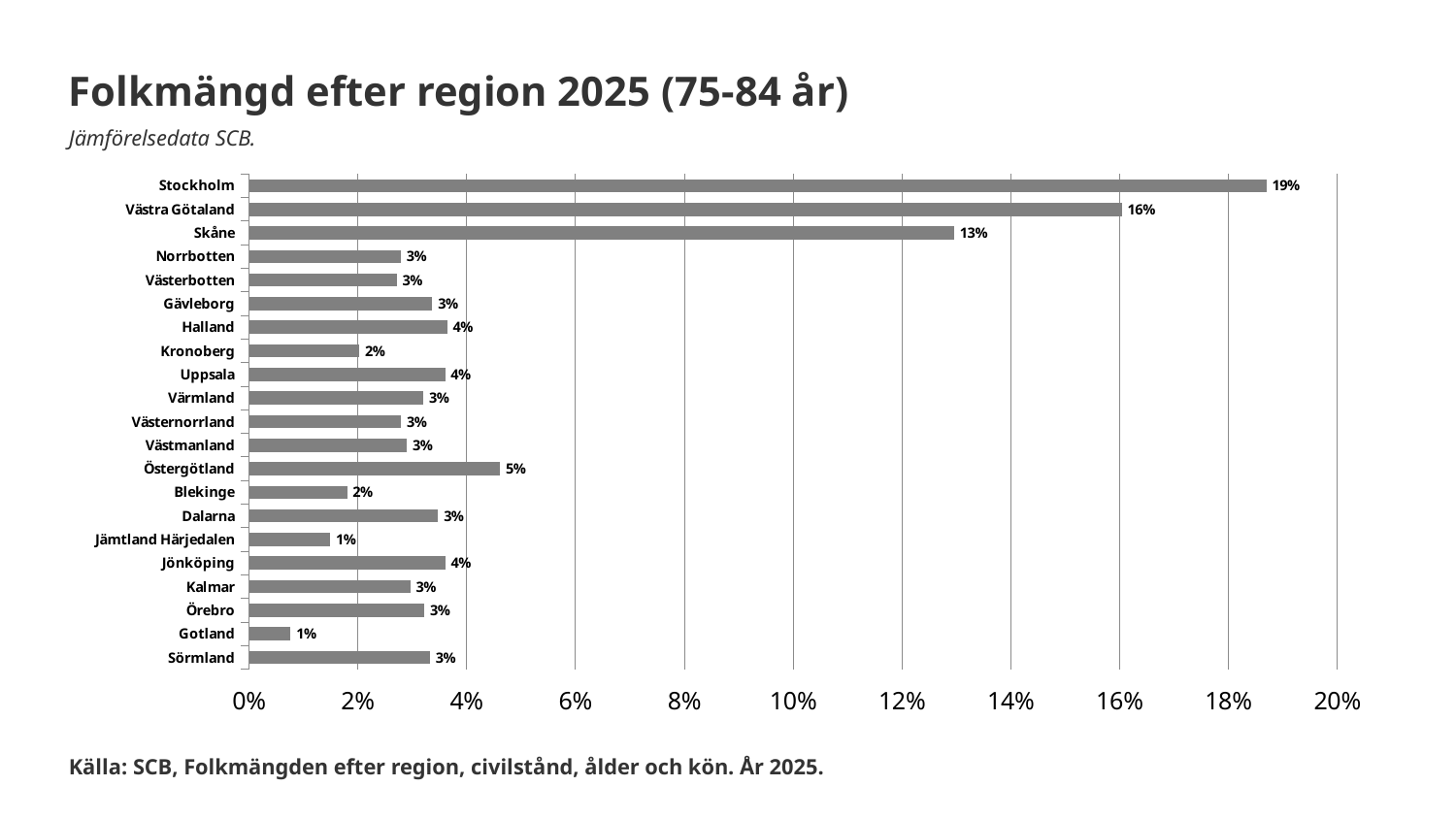
Is the value for Skåne greater or less than 12%? greater What is the difference between the values for Västra Götaland and Skåne? 3% What kind of chart is shown on the slide? Bar chart What is the value for Östergötland? 5% Which is larger, the value for Östergötland or the value for Blekinge? Östergötland What is the value for Kronoberg? 2% What is the value for Västra Götaland? 16% Which region has the highest value? Stockholm What is the difference between the values for Stockholm and Skåne? 6% What is the value for Stockholm? 19% How many regions are shown in the chart? 21 Is the value for Gotland greater or less than 2%? less